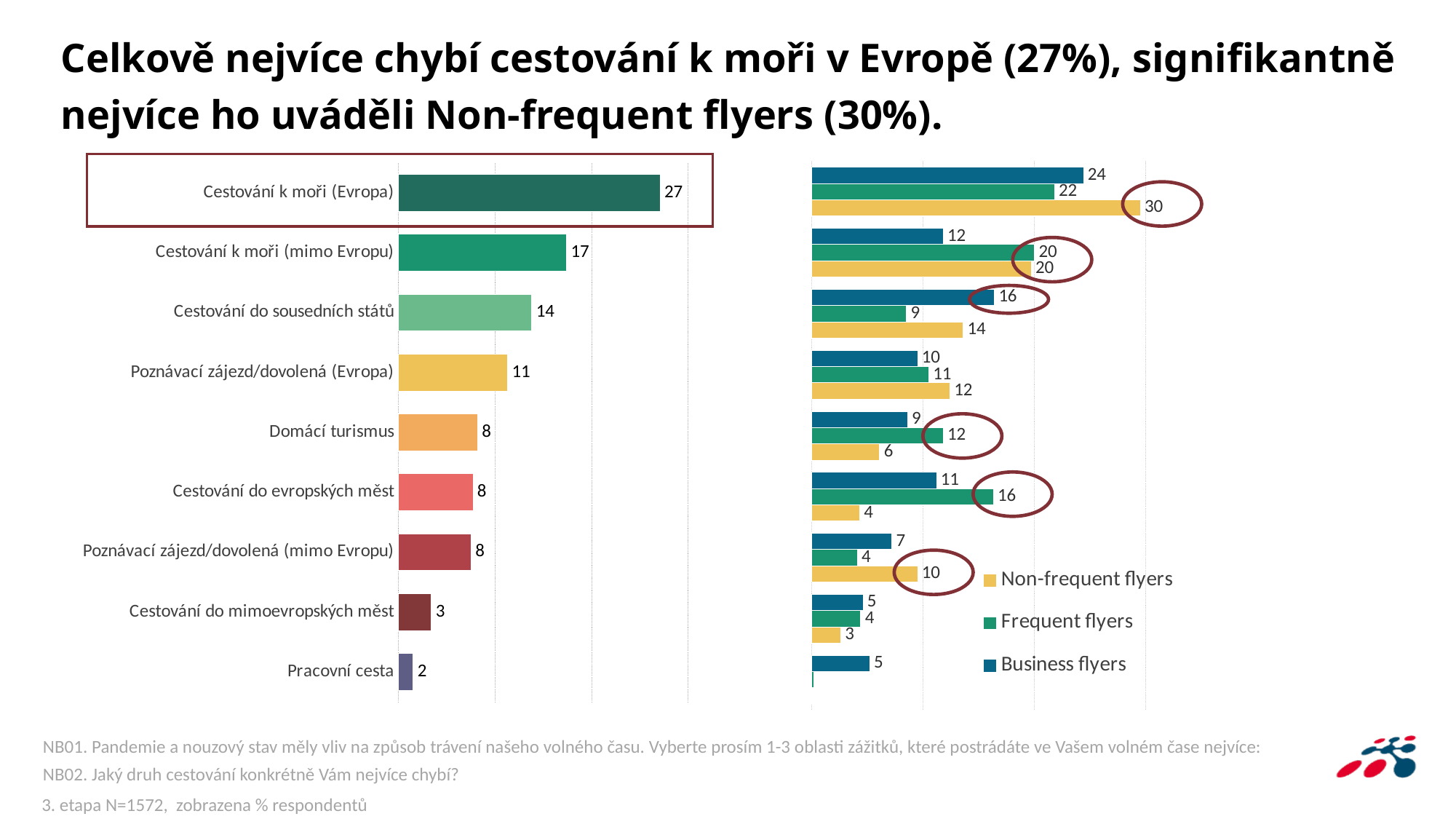
In the right chart, which series is shown in yellow according to the legend? Non-frequent flyers In the left chart, which is larger: Cestování do sousedních států or Poznávací zájezd/dovolená (Evropa)? Cestování do sousedních států In the left chart, what is the difference between Cestování k moři (Evropa) and Cestování k moři (mimo Evropu)? 10 In the left chart, which category has the lowest value? Pracovní cesta In the left chart, what is the value for Cestování k moři (Evropa)? 27 In the left chart, what is the value for Cestování do mimoevropských měst? 3 What kind of chart is the left chart? bar chart In the right chart, in the row for Cestování do evropských měst, what is the difference between Frequent flyers and Non-frequent flyers? 12 In the right chart, how many series does the legend list? 3 In the right chart, what is the value for Non-frequent flyers in the top row (Cestování k moři (Evropa))? 30 In the left chart, how many categories are shown? 9 In the right chart, what is the value for Business flyers in the top row (Cestování k moři (Evropa))? 24